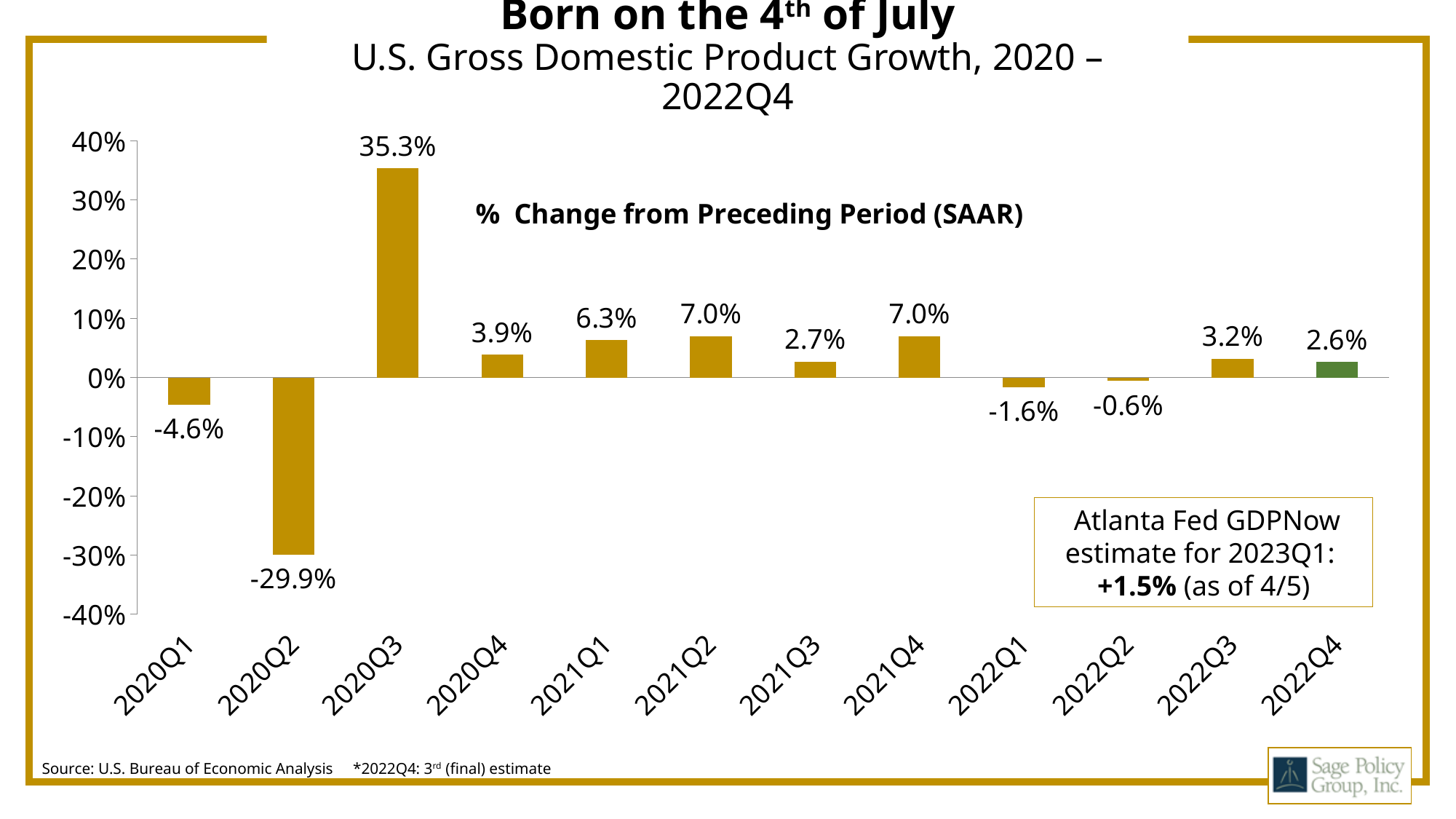
What is the Atlanta Fed GDPNow estimate for 2023Q1 shown in the text box? +1.5% What kind of chart is shown on the slide? Bar chart Which quarter has the lowest GDP growth? 2020Q2 What is the GDP growth value for 2020Q3? 35.3% Which quarter has the larger GDP growth, 2022Q3 or 2021Q3? 2022Q3 What is the GDP growth value for 2022Q4? 2.6% Which quarter has the highest GDP growth? 2020Q3 Do the values rise or fall from 2021Q4 to 2022Q1? Fall Is the value for 2020Q2 greater or less than -20%? less How many quarters are shown on the chart? 12 What is the difference between the GDP growth values for 2021Q1 and 2020Q4? 2.4% What is the GDP growth value for 2022Q1? -1.6%